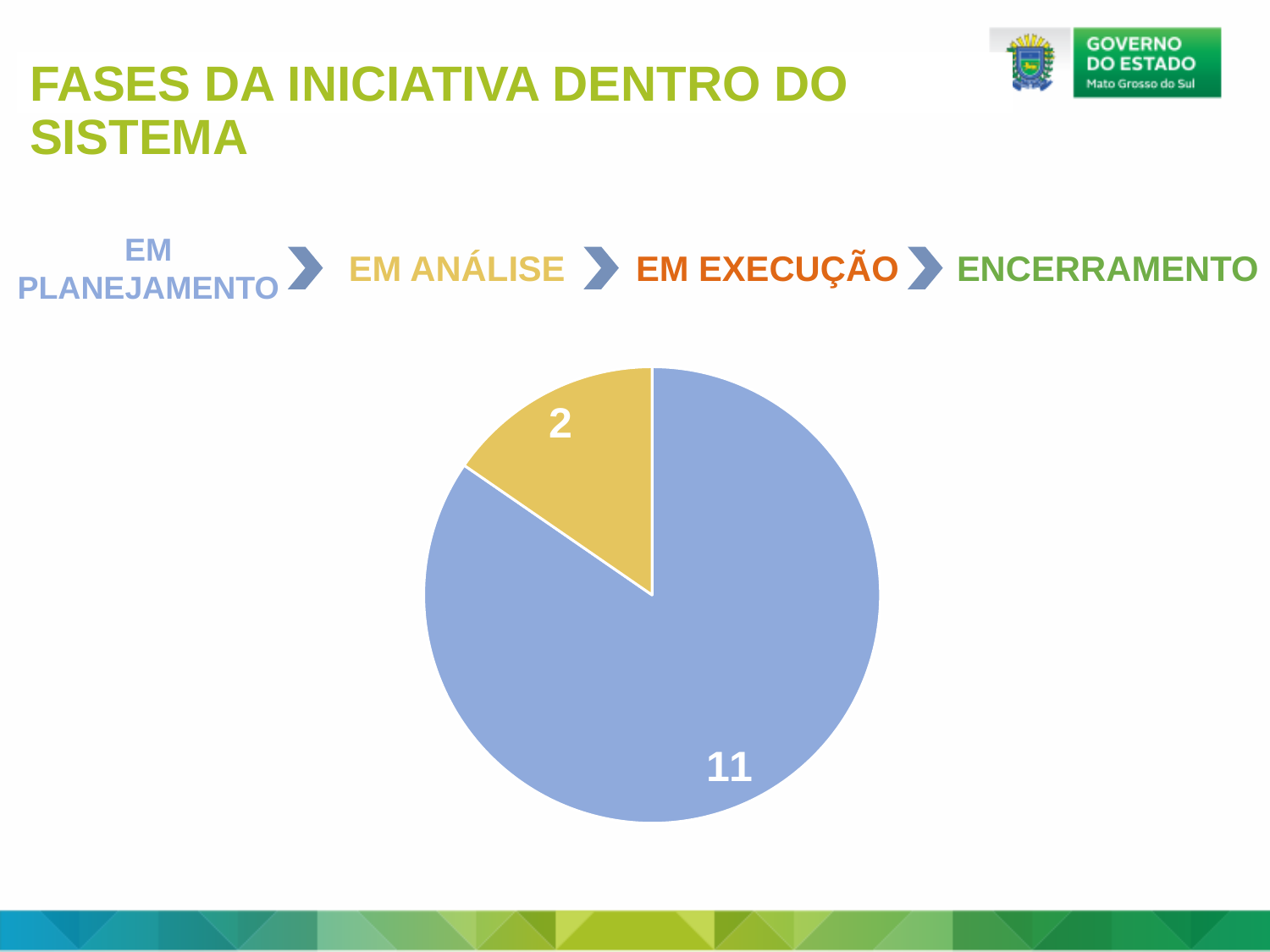
Which slice of the pie chart has the largest value? the blue slice (11) What kind of chart is shown on the slide? pie chart Which slice of the pie chart has the smallest value? the yellow slice (2) What value is printed on the blue slice of the pie chart? 11 What is the title of the slide containing the pie chart? FASES DA INICIATIVA DENTRO DO SISTEMA Which is larger, the blue slice or the yellow slice? the blue slice What value is printed on the yellow slice of the pie chart? 2 What is the difference between the blue slice value and the yellow slice value? 9 Which phase label above the chart is shown in the same colour as the larger slice of the pie? EM PLANEJAMENTO How many slices does the pie chart have? 2 What is the total of the values shown on the pie chart? 13